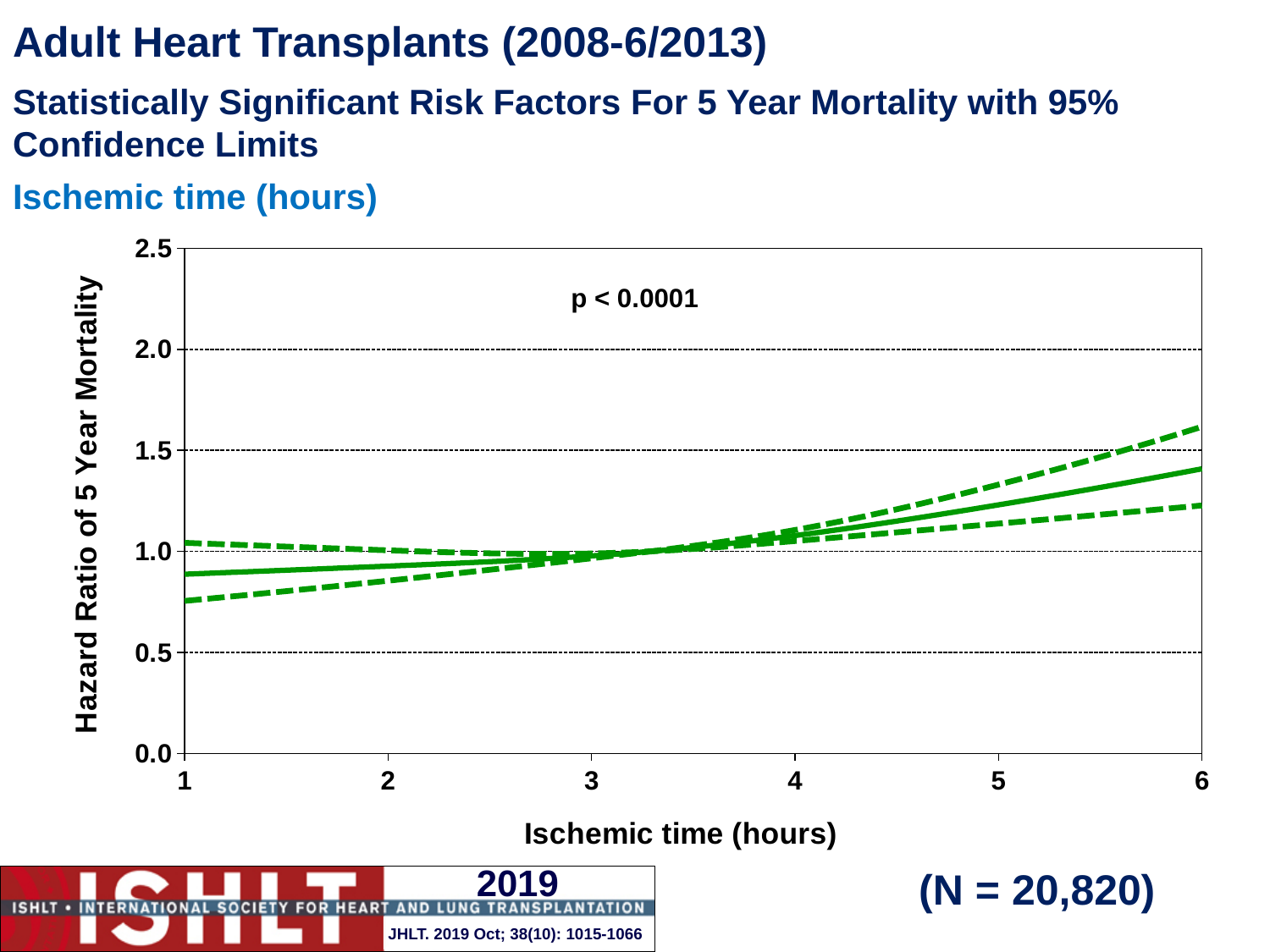
Is the hazard ratio on the solid line at an ischemic time of 1 hour greater or less than 1.0? less Is the upper dashed confidence limit at an ischemic time of 6 hours greater or less than 1.5? greater How many lines are plotted on the chart? 3 What p-value is printed on the chart? p < 0.0001 Is the hazard ratio on the solid line at an ischemic time of 6 hours greater or less than 1.0? greater What kind of chart is shown on the slide? line chart What is the label of the x axis? Ischemic time (hours) Does the hazard ratio of 5 year mortality rise or fall as ischemic time increases from 1 to 6 hours? rise